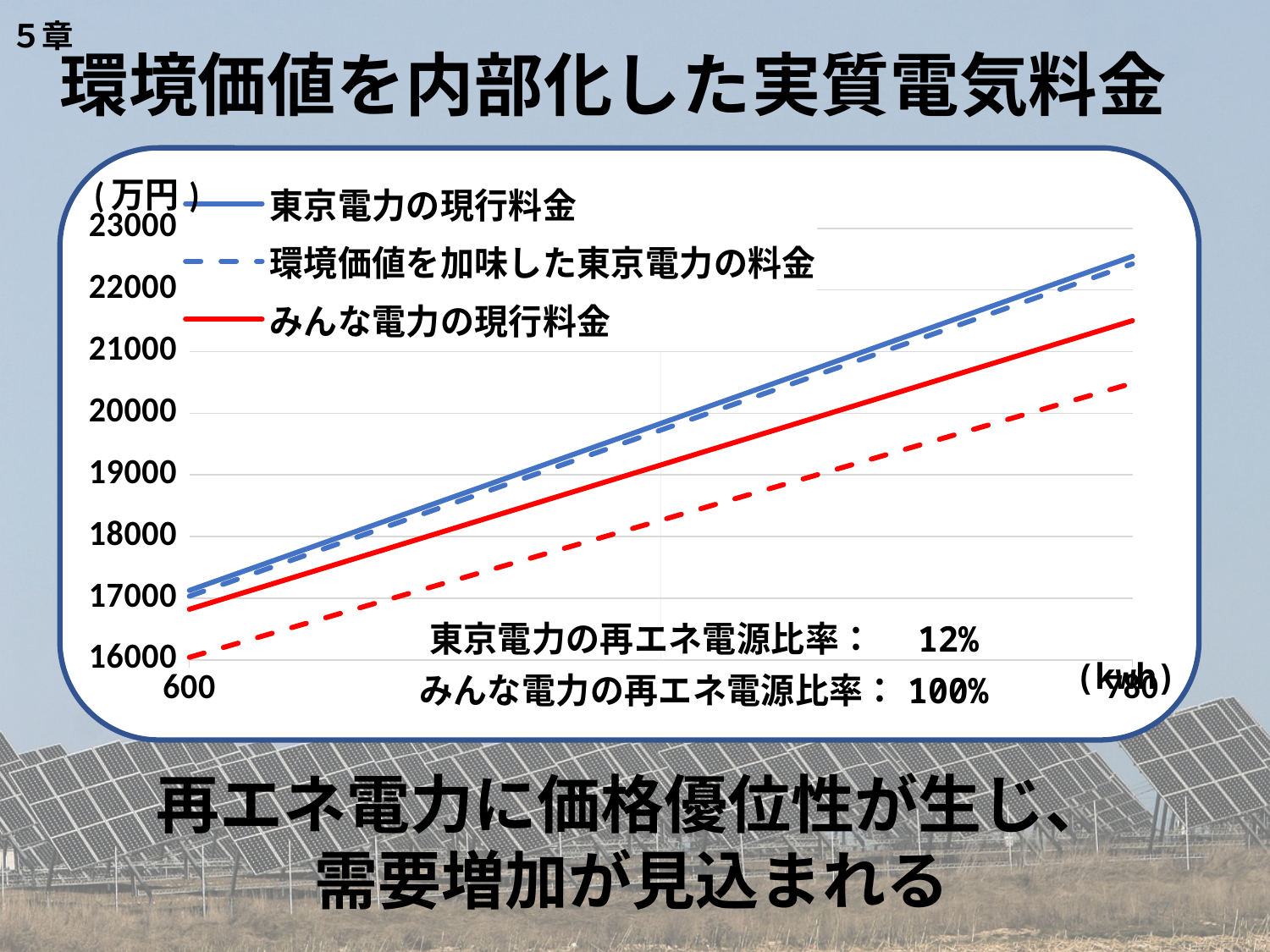
Is the value for みんな電力の現行料金 at 600 kWh greater or less than 17000? less Is the value for 環境価値を加味した東京電力の料金 at 780 kWh greater or less than 22000? greater How many series does the chart legend list? 3 Is the value for みんな電力の現行料金 at 780 kWh greater or less than 21000? greater What is the title of the chart on the slide? 環境価値を内部化した実質電気料金 What kind of chart is shown on the slide? line chart According to the text on the chart, what is みんな電力の再エネ電源比率? 100% Of the three series listed in the legend, which has the lowest value at 780 kWh? みんな電力の現行料金 Do the values for みんな電力の現行料金 rise or fall along the x axis? rise At 780 kWh, which is larger: 東京電力の現行料金 or みんな電力の現行料金? 東京電力の現行料金 Do the values for 東京電力の現行料金 rise or fall as kWh increases from 600 to 780? rise